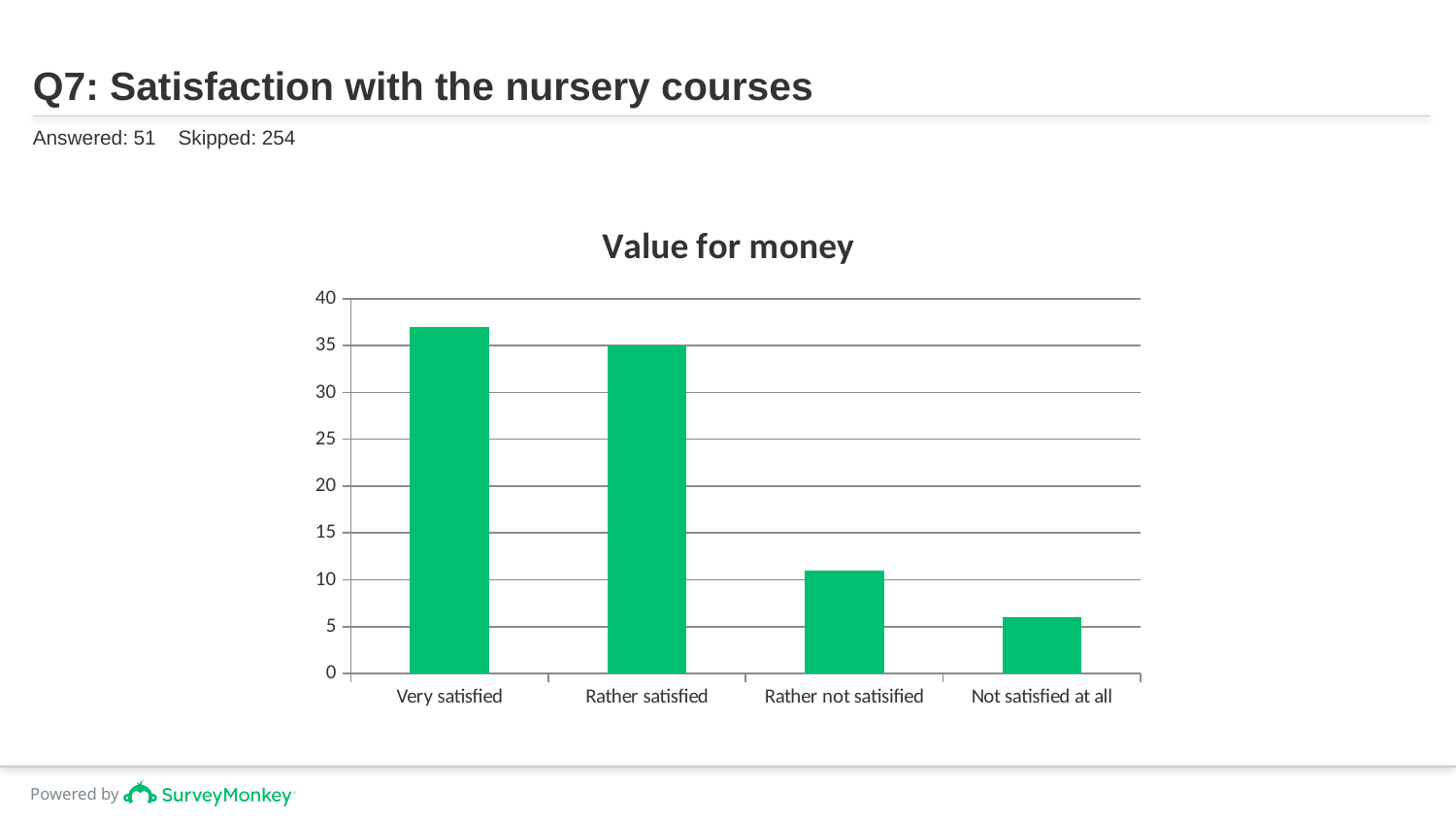
Do the values rise or fall moving from left to right along the x axis? fall Is the value for Rather not satisified greater or less than 15? less What is the title of the chart? Value for money Which is larger, the value for Rather not satisified or the value for Not satisfied at all? Rather not satisified How many categories are shown on the x axis of the chart? 4 Is the value for Very satisfied greater or less than 35? greater What type of chart is shown on the slide? bar chart Is the value for Not satisfied at all greater or less than 10? less Which category has the lowest value in the chart? Not satisfied at all What colour are the bars in the chart? green What is the value for Rather satisfied? 35